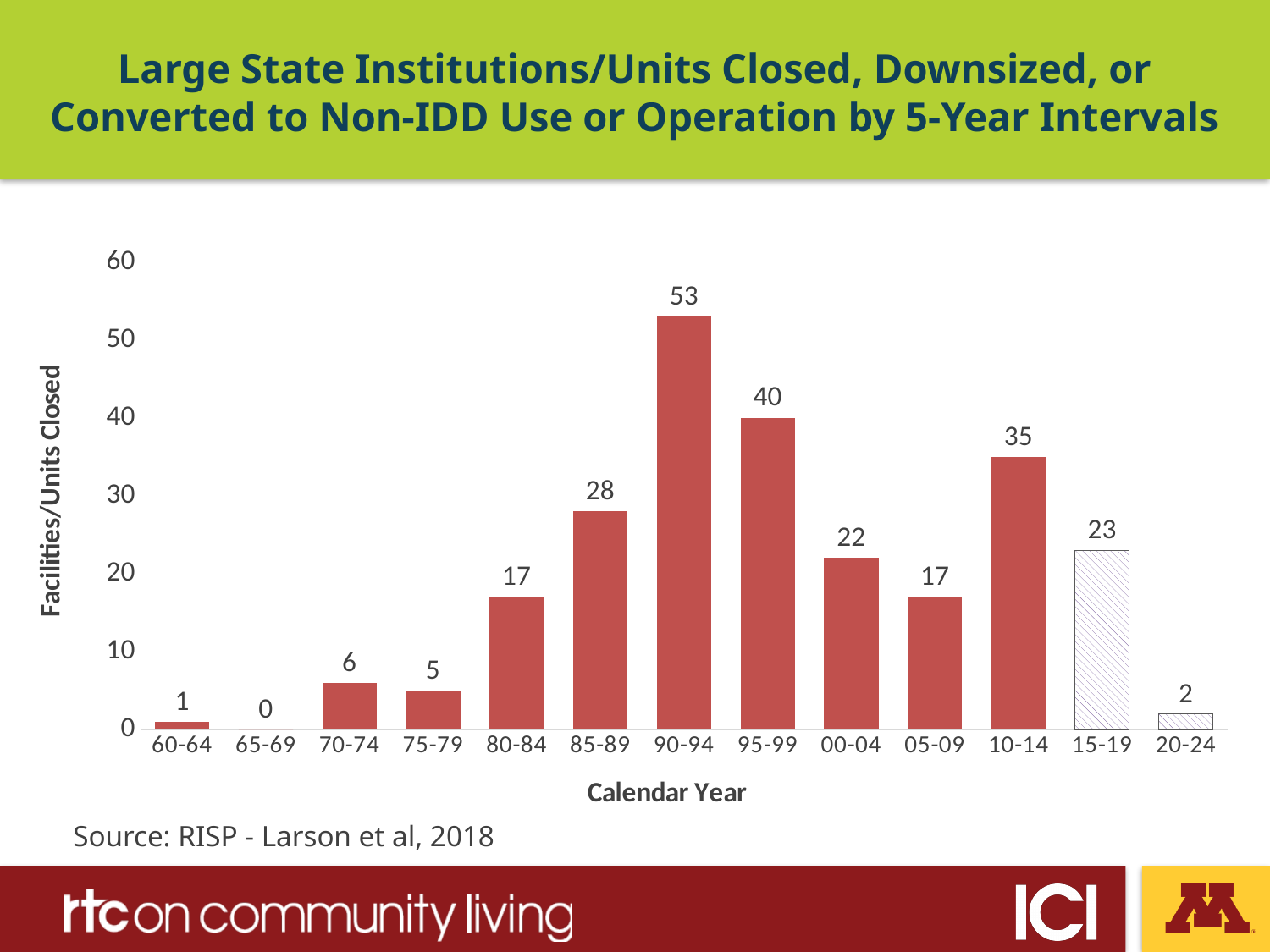
What is the difference between the values for 90-94 and 95-99? 13 Is the value for 10-14 greater or less than 30? greater How many calendar year intervals are shown on the x axis? 13 Which interval has a larger value, 85-89 or 00-04? 85-89 What is the value for the 20-24 interval? 2 Which calendar year interval has the highest number of facilities/units closed? 90-94 What kind of chart is shown on the slide? Bar chart What is the difference between the values for 10-14 and 15-19? 12 What is the value for the 80-84 interval? 17 How many facilities/units were closed, downsized, or converted in the 90-94 interval? 53 Which calendar year interval has the lowest number of facilities/units closed? 65-69 What is the label of the y axis? Facilities/Units Closed